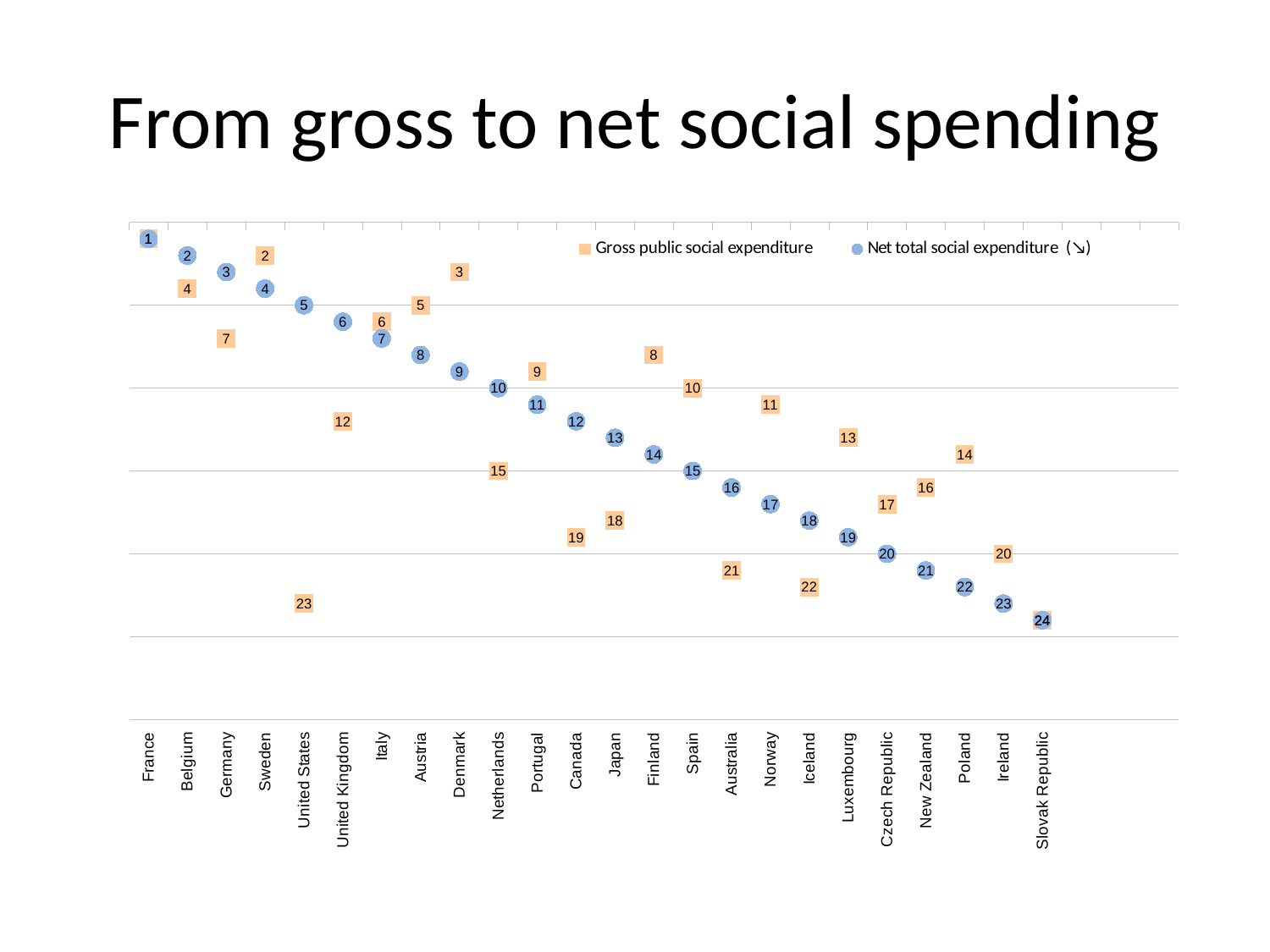
How many series does the legend list? 2 What is the Gross public social expenditure rank for Denmark? 3 Which is the larger number for Germany: the Gross public social expenditure rank or the Net total social expenditure rank? Gross public social expenditure rank What kind of chart is shown on the slide? scatter chart What is the Gross public social expenditure rank for Canada? 19 How many countries are shown on the x axis? 24 What is the difference between the Gross public social expenditure rank and the Net total social expenditure rank for the United States? 18 What is the Net total social expenditure rank for the United States? 5 What is the Net total social expenditure rank for Japan? 13 What is the title of the slide? From gross to net social spending What is the Gross public social expenditure rank for the United States? 23 Which country has the Net total social expenditure rank of 24? Slovak Republic